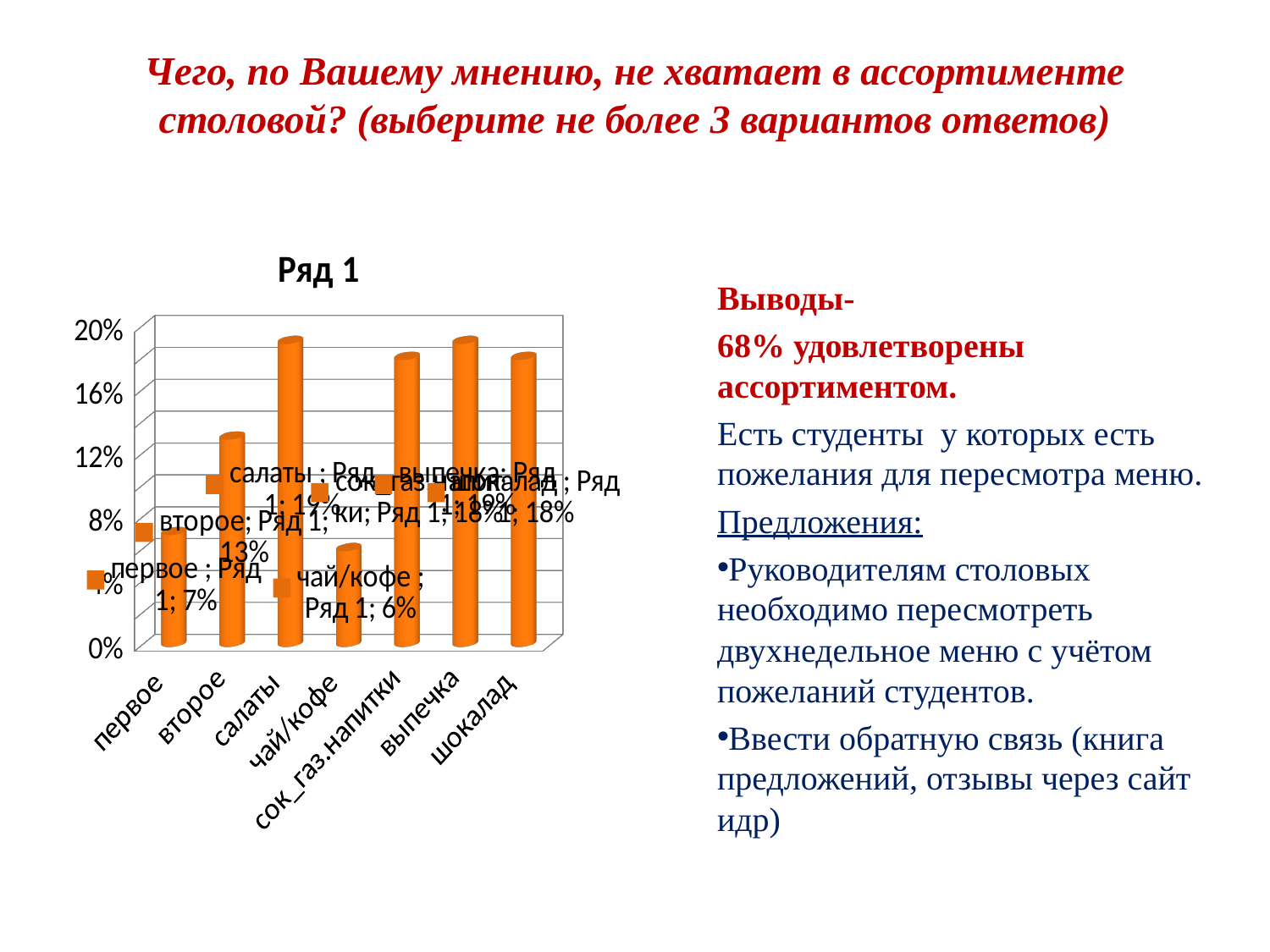
Which is larger, the value for второе or the value for первое? второе What kind of chart is shown on the slide? bar chart What is the value for первое? 7% What is the value for шоколад? 18% What is the difference between the values for второе and первое? 6% What is the value for чай/кофе? 6% Which category has the lowest value? чай/кофе What is the value for второе? 13% Is the value for салаты greater or less than 16%? greater What is the value for сок_газ.напитки? 18% How many categories are shown on the x axis? 7 What is the difference between the values for шоколад and чай/кофе? 12%